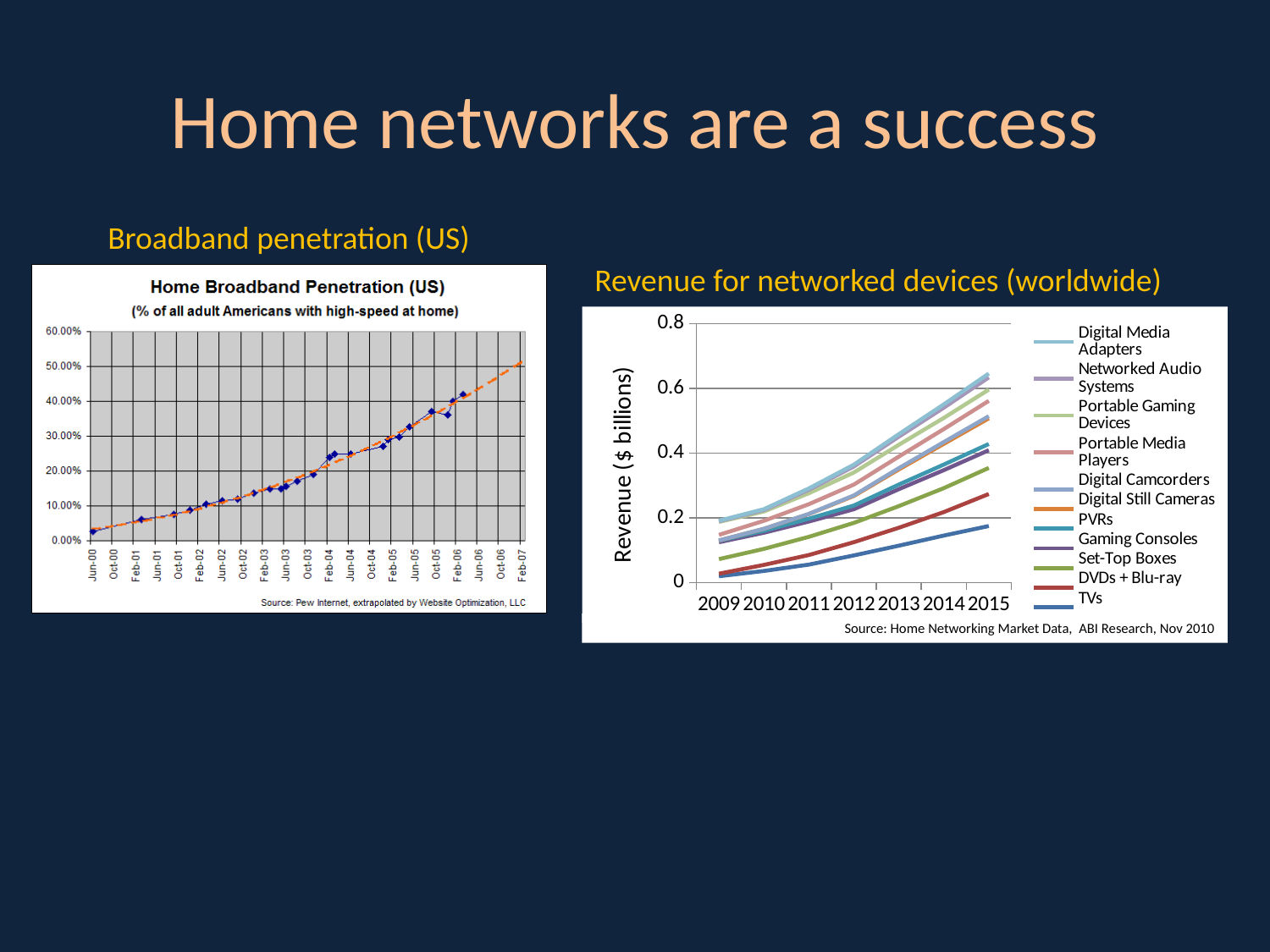
How many series does the legend of the 'Revenue for networked devices (worldwide)' chart list? 11 In the 'Home Broadband Penetration (US)' chart on the left, does broadband penetration rise or fall from Jun-00 to Feb-07? rise In the 'Home Broadband Penetration (US)' chart on the left, is the value at Jun-00 greater or less than 10.00%? less In the 'Revenue for networked devices (worldwide)' chart, do the series rise or fall from 2009 to 2015? rise What is the y-axis label of the 'Revenue for networked devices (worldwide)' chart? Revenue ($ billions) How many years are shown on the x axis of the 'Revenue for networked devices (worldwide)' chart? 7 In the 'Revenue for networked devices (worldwide)' chart, is the 2015 value for TVs greater or less than 0.2? less What kind of chart is the 'Revenue for networked devices (worldwide)' chart on the right? line chart